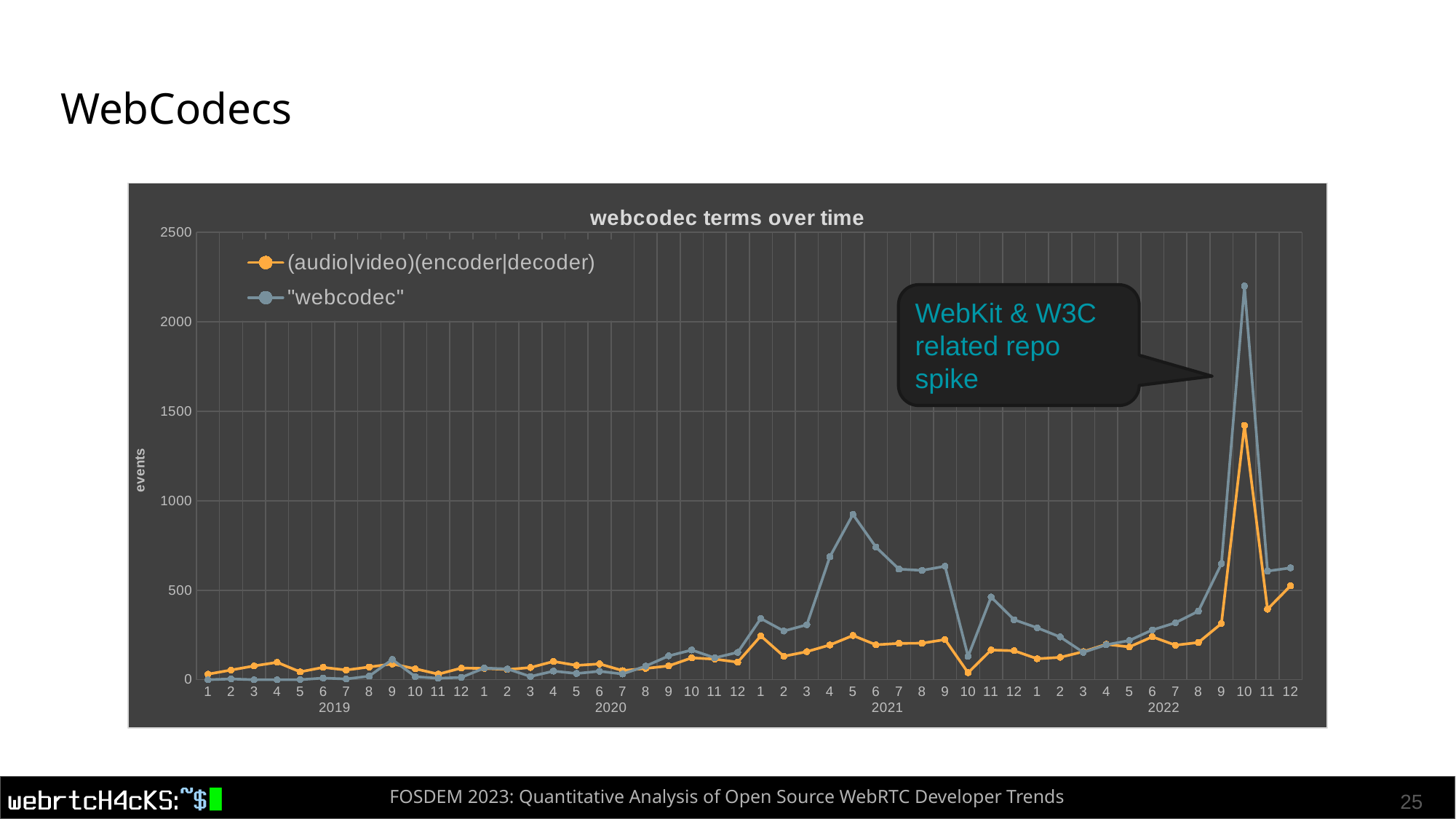
In May 2021, which series has the higher value, "webcodec" or (audio|video)(encoder|decoder)? "webcodec" What is the title of the chart? webcodec terms over time In October 2022, which series has the higher value, "webcodec" or (audio|video)(encoder|decoder)? "webcodec" How many series does the legend list? 2 Is the value for (audio|video)(encoder|decoder) in October 2022 greater or less than 1500? less In which month and year does the "webcodec" series reach its highest value? October 2022 Is the value for (audio|video)(encoder|decoder) in October 2022 greater or less than 1000? greater Is the value for "webcodec" in May 2021 greater or less than 500? greater What label is shown on the y axis of the chart? events How many years are covered on the x axis of the chart? 4 What kind of chart is shown on the slide? line chart